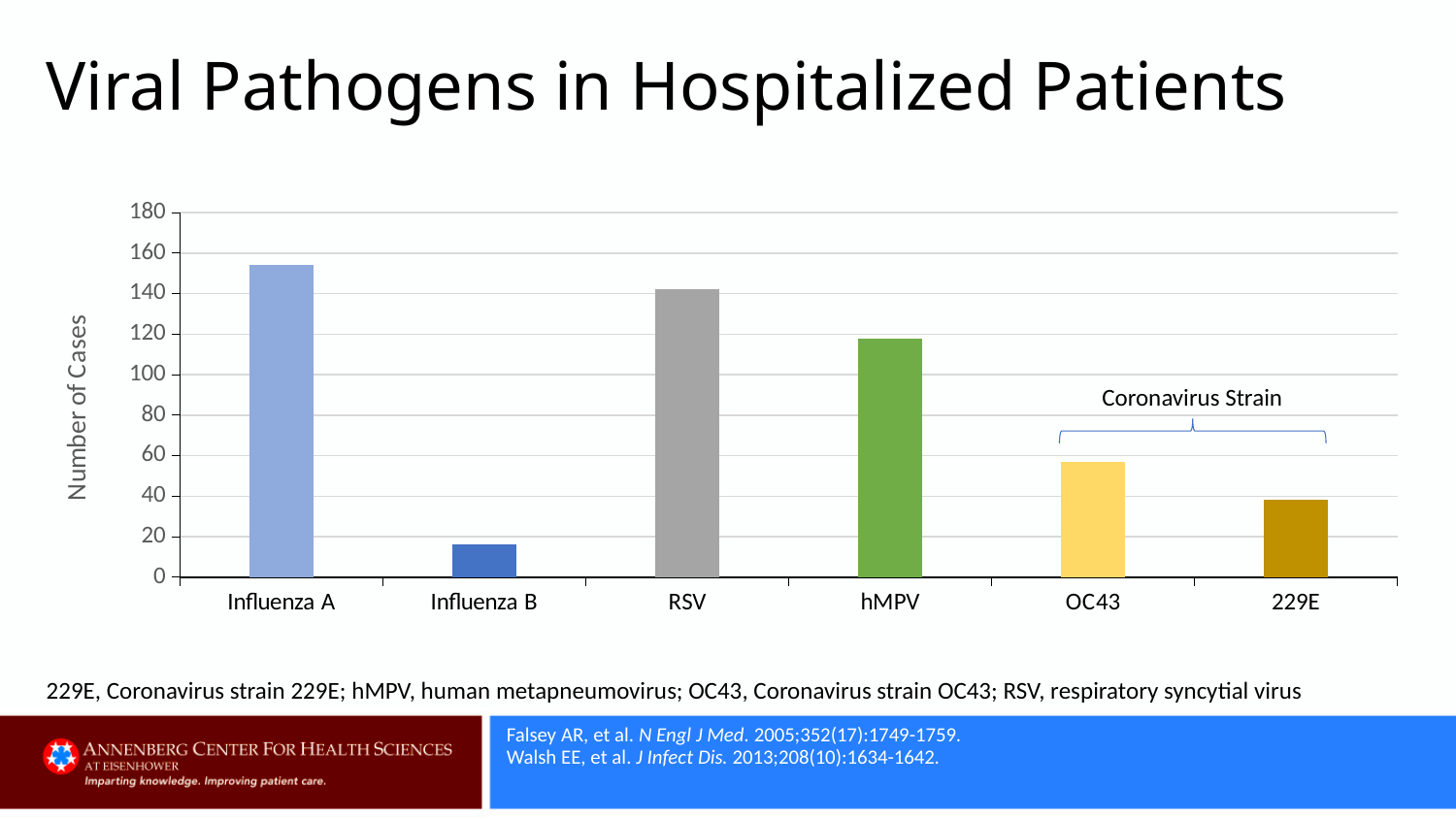
Which has more cases, OC43 or 229E? OC43 Is the value for OC43 greater or less than 40? greater Which pathogen has the highest number of cases? Influenza A Is the value for hMPV greater or less than 100? greater What kind of chart is shown on the slide? Bar chart Is the value for Influenza A greater or less than 140? greater Which has more cases, RSV or hMPV? RSV How many viral pathogen categories are plotted on the chart? 6 Which pathogen has the lowest number of cases? Influenza B